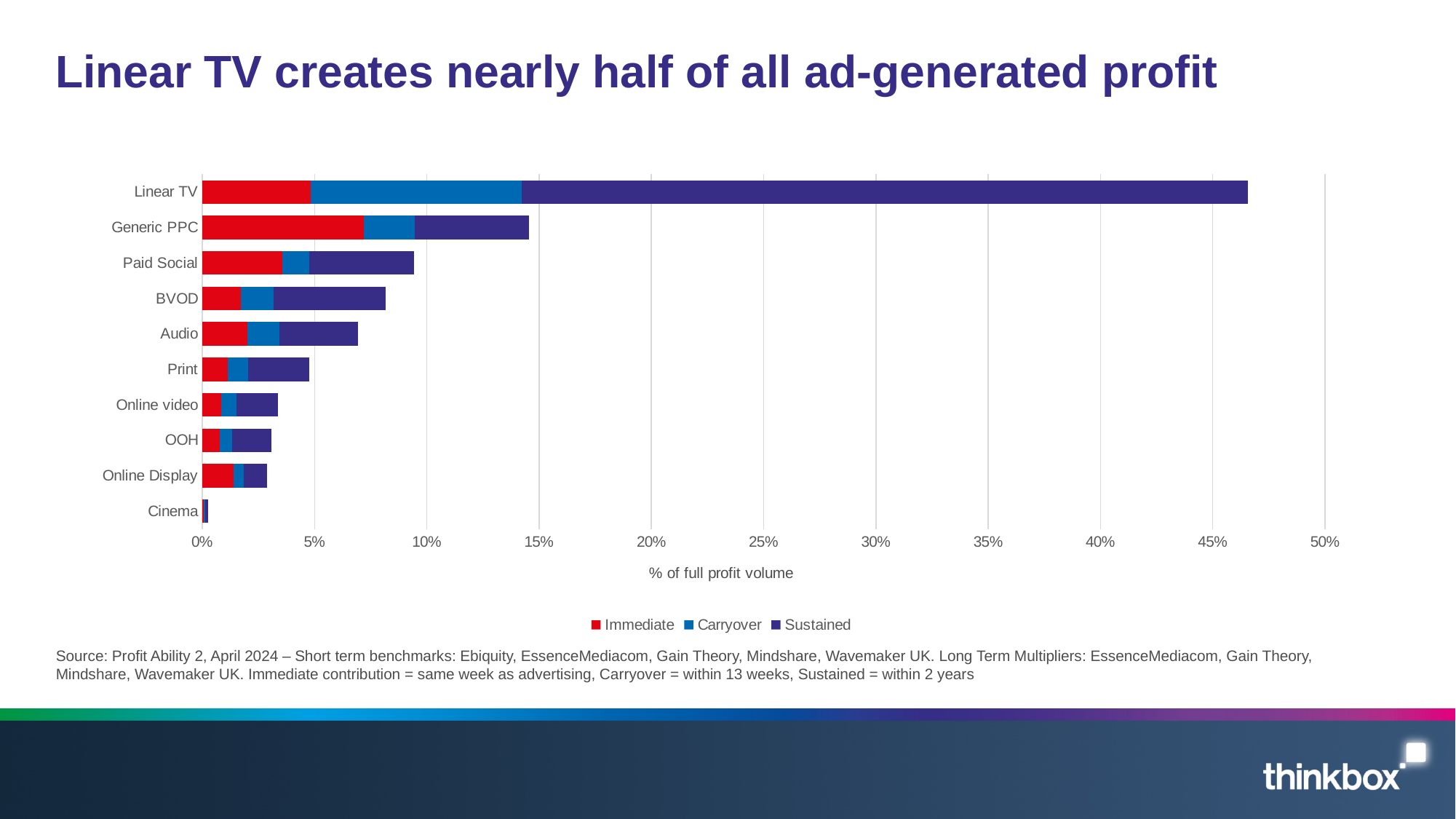
Which category has the highest total share of full profit volume? Linear TV Which category has the lowest total share of full profit volume? Cinema Which has a larger total share of full profit volume, BVOD or Audio? BVOD Is the total value for Online video greater or less than 5%? less Is the total value for Generic PPC greater or less than 15%? less How many series does the legend list? 3 What kind of chart is shown on the slide? Stacked bar chart How many categories (media channels) are plotted on the chart? 10 Which has a larger total share of full profit volume, Generic PPC or Paid Social? Generic PPC Is the total value for Linear TV greater or less than 45%? greater What is the label on the horizontal axis of the chart? % of full profit volume